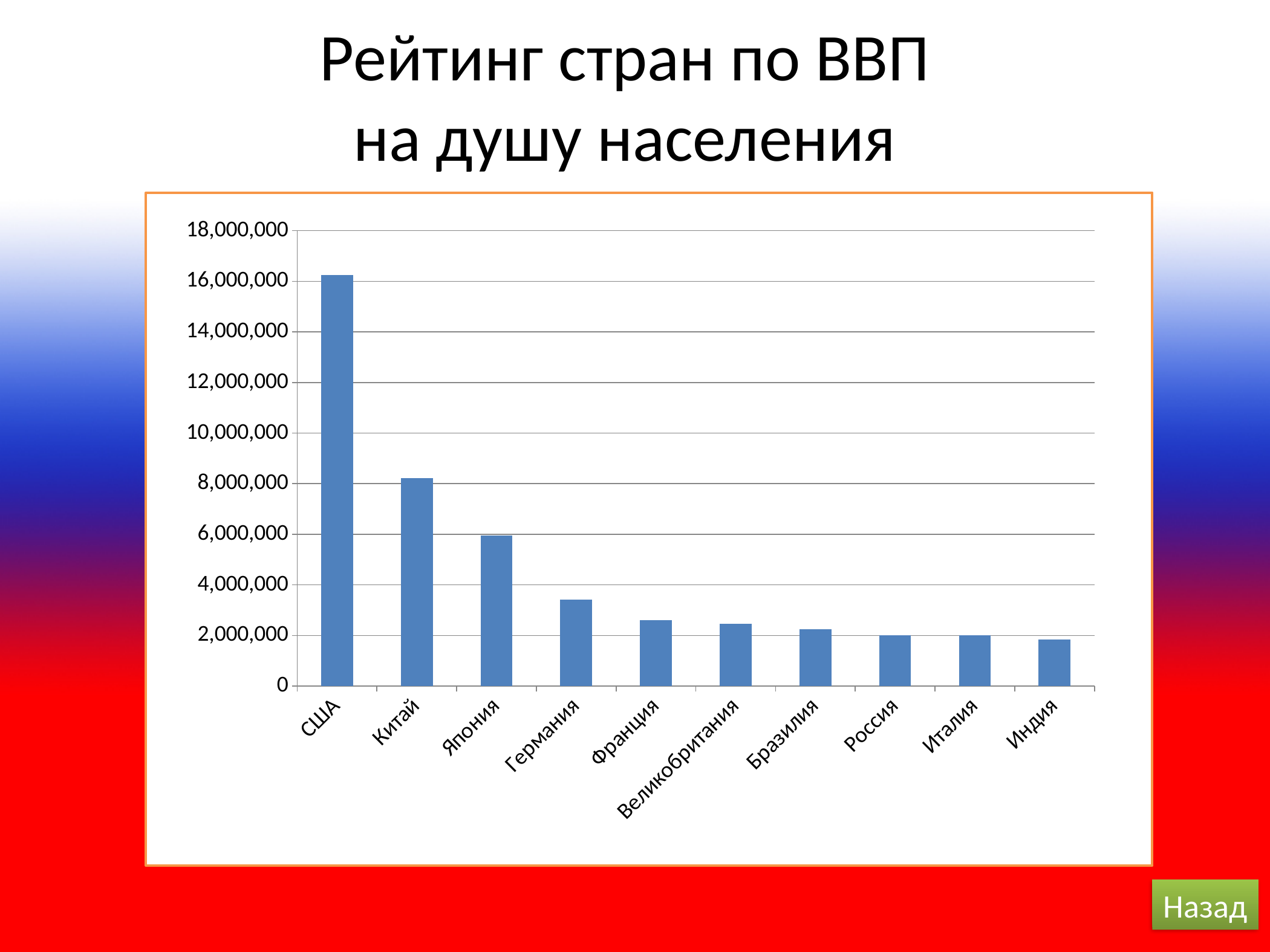
Do the bar values rise or fall from left to right along the x axis? fall How many countries are shown on the x axis of the chart? 10 Which country has the lowest bar in the chart? Индия Which has a larger value, Китай or Япония? Китай Is the value for Великобритания greater or less than 2,000,000? greater Is the value for Китай greater or less than 6,000,000? greater Which has a larger value, Германия or Франция? Германия Which country has the highest bar in the chart? США What kind of chart is shown on the slide? bar chart Is the value for США greater or less than 14,000,000? greater What is the title of the slide containing the chart? Рейтинг стран по ВВП на душу населения